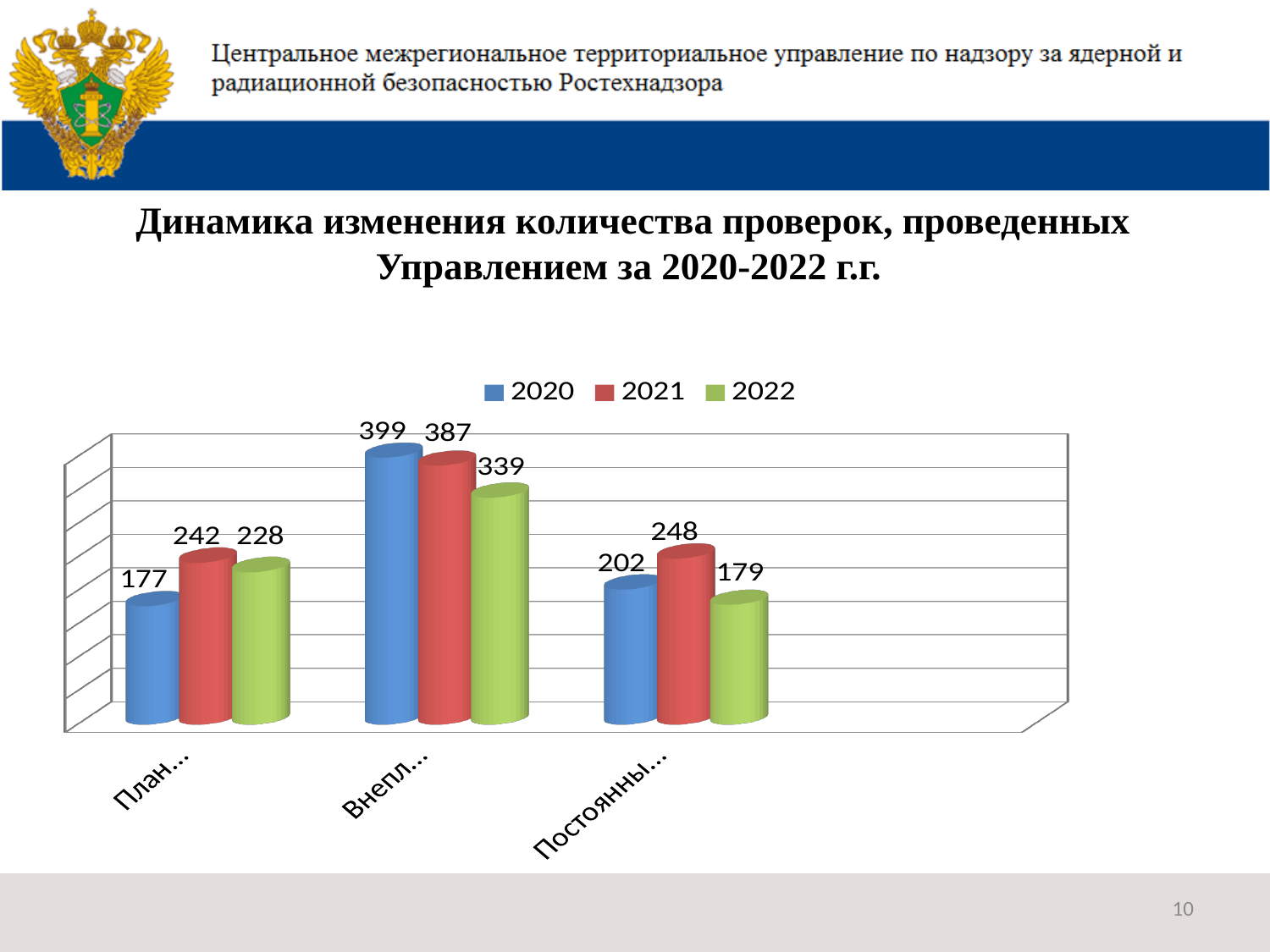
Which year has the lowest value in the third category (labelled "Постоянны...")? 2022 What is the value for 2020 in the first category (labelled "План...")? 177 Which category has the highest value for the 2020 series? Внепл... In the first category (labelled "План..."), which is larger: the 2021 value or the 2022 value? 2021 How many categories are shown on the x axis? 3 What is the difference between the 2020 and 2021 values in the second category (labelled "Внепл...")? 12 What kind of chart is shown on the slide? Bar chart What is the value for 2022 in the second category (labelled "Внепл...")? 339 How many series does the legend list? 3 Which colour represents the 2022 series in the legend? Green What is the value for 2021 in the third category (labelled "Постоянны...")? 248 Do the values for the second category (labelled "Внепл...") rise or fall from 2020 to 2022? Fall